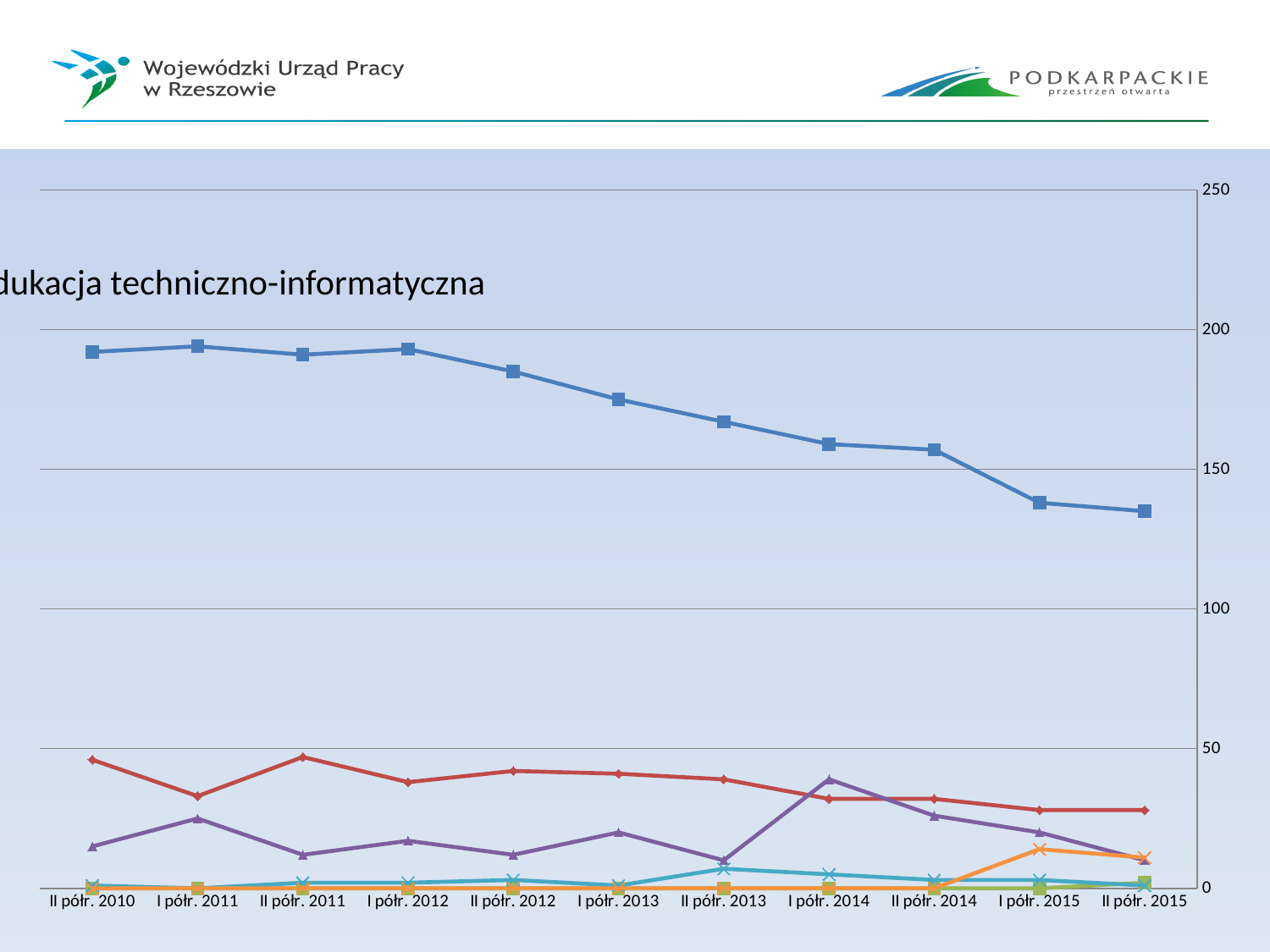
How many time periods are shown on the x axis of the chart? 11 What is the first period shown on the x axis? II półr. 2010 What kind of chart is shown on the slide? line chart What is the last period shown on the x axis? II półr. 2015 Is the value of the red line at II półr. 2010 greater or less than 50? less At I półr. 2014, which is larger: the blue line or the red line? the blue line Does the blue line (with square markers) rise or fall overall from II półr. 2010 to II półr. 2015? fall In which period does the blue line reach its lowest value? II półr. 2015 Is the value of the blue line at I półr. 2012 greater or less than 200? less At II półr. 2011, which is larger: the red line or the purple line? the red line Is the value of the blue line at II półr. 2010 greater or less than 150? greater